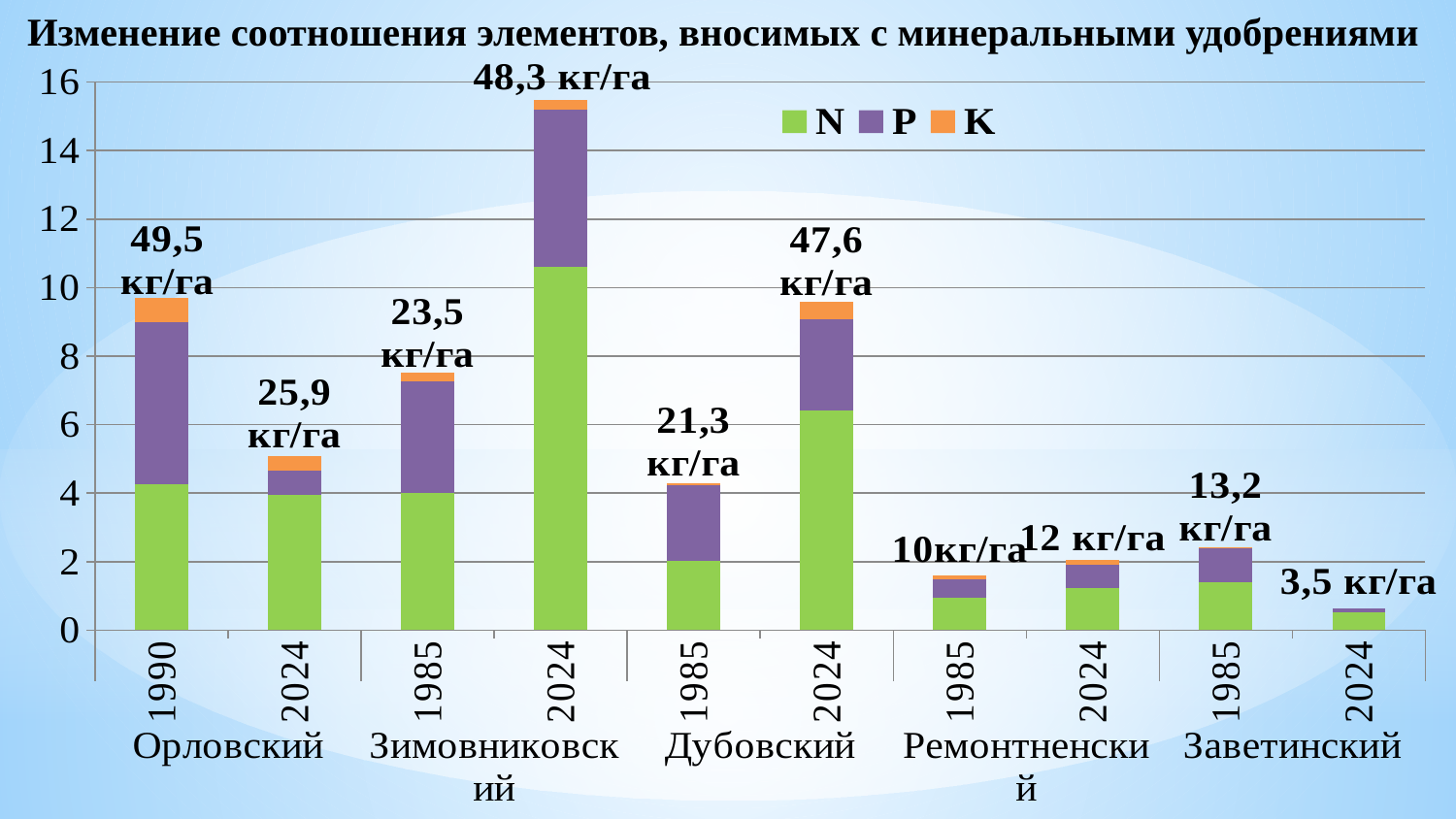
How many bars are plotted in the chart? 10 Which bar is the shortest in the chart? Заветинский 2024 Which bar is the tallest in the chart? Зимовниковский 2024 What kind of chart is shown on the slide? stacked bar chart What is the difference between the printed values for Орловский 1990 and Орловский 2024? 23,6 кг/га What value is printed above the bar for Зимовниковский 2024? 48,3 кг/га What value is printed above the bar for Орловский 1990? 49,5 кг/га Which printed value is larger: Дубовский 2024 or Дубовский 1985? Дубовский 2024 Is the stacked total of the bar for Зимовниковский 2024 greater or less than 14? greater What value is printed above the bar for Заветинский 2024? 3,5 кг/га Which series are listed in the legend? N, P, K How many series does the legend list? 3